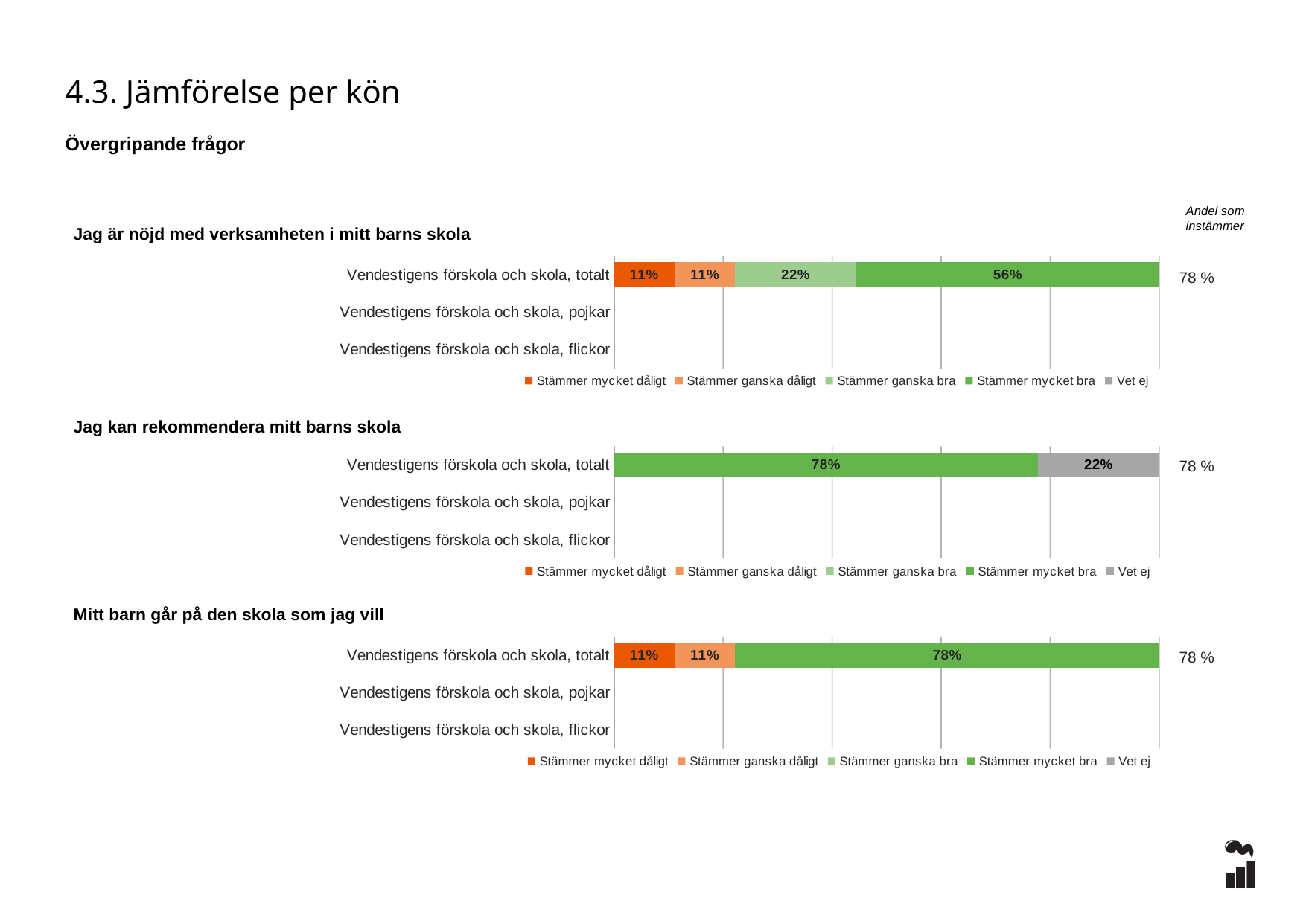
What kind of chart is 'Jag är nöjd med verksamheten i mitt barns skola'? Stacked bar chart In the chart 'Mitt barn går på den skola som jag vill', what is the value of 'Stämmer mycket bra' for 'Vendestigens förskola och skola, totalt'? 78% What is the 'Andel som instämmer' value shown for 'Vendestigens förskola och skola, totalt' in the chart 'Jag kan rekommendera mitt barns skola'? 78 % In the chart 'Jag är nöjd med verksamheten i mitt barns skola', what is the difference between 'Stämmer mycket bra' and 'Stämmer ganska bra' for the 'totalt' bar? 34 percentage points In the chart 'Jag är nöjd med verksamheten i mitt barns skola', what is the value of 'Stämmer ganska bra' for 'Vendestigens förskola och skola, totalt'? 22% In the chart 'Mitt barn går på den skola som jag vill', what is the combined share of 'Stämmer mycket dåligt' and 'Stämmer ganska dåligt' for the 'totalt' bar? 22% In the chart 'Jag är nöjd med verksamheten i mitt barns skola', what is the value of 'Stämmer mycket bra' for 'Vendestigens förskola och skola, totalt'? 56% How many series does the legend list in the chart 'Jag kan rekommendera mitt barns skola'? 5 How many category rows are shown in the chart 'Mitt barn går på den skola som jag vill'? 3 In the chart 'Jag kan rekommendera mitt barns skola', what is the value of 'Vet ej' for 'Vendestigens förskola och skola, totalt'? 22% In the chart 'Jag kan rekommendera mitt barns skola', which is larger for the 'totalt' bar: 'Stämmer mycket bra' or 'Vet ej'? Stämmer mycket bra In the chart 'Jag är nöjd med verksamheten i mitt barns skola', which segment of the 'totalt' bar is the largest? Stämmer mycket bra